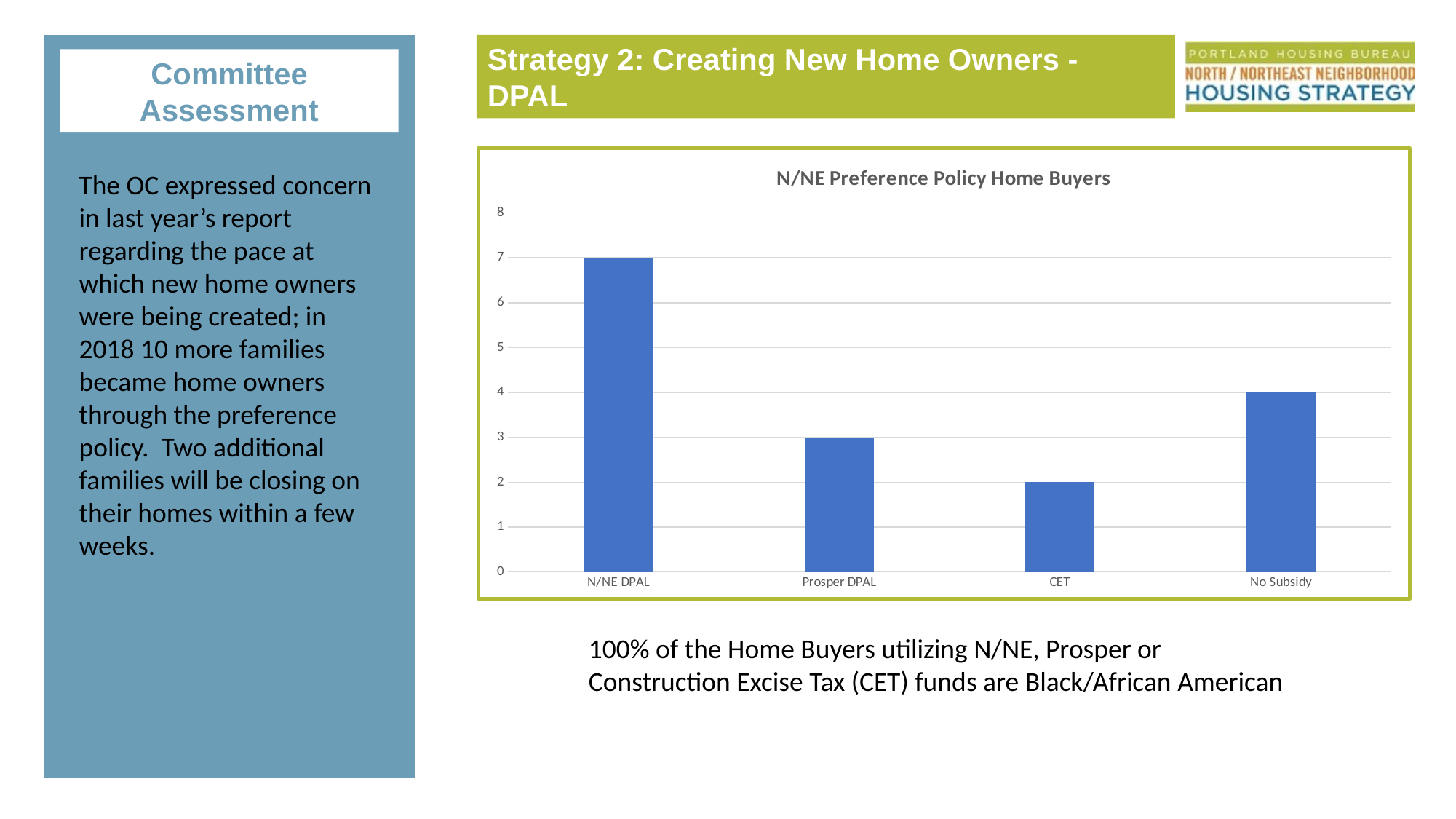
What is the value for CET? 2 Is the value for N/NE DPAL greater or less than 5? greater What is the value for N/NE DPAL? 7 What is the difference between the values for N/NE DPAL and No Subsidy? 3 What type of chart is shown on the slide? bar chart What is the title of the chart? N/NE Preference Policy Home Buyers Which category has the lowest value? CET Which is larger, the value for Prosper DPAL or the value for No Subsidy? No Subsidy What is the value for No Subsidy? 4 What is the value for Prosper DPAL? 3 How many categories are shown on the x axis of the chart? 4 Which category has the highest value? N/NE DPAL